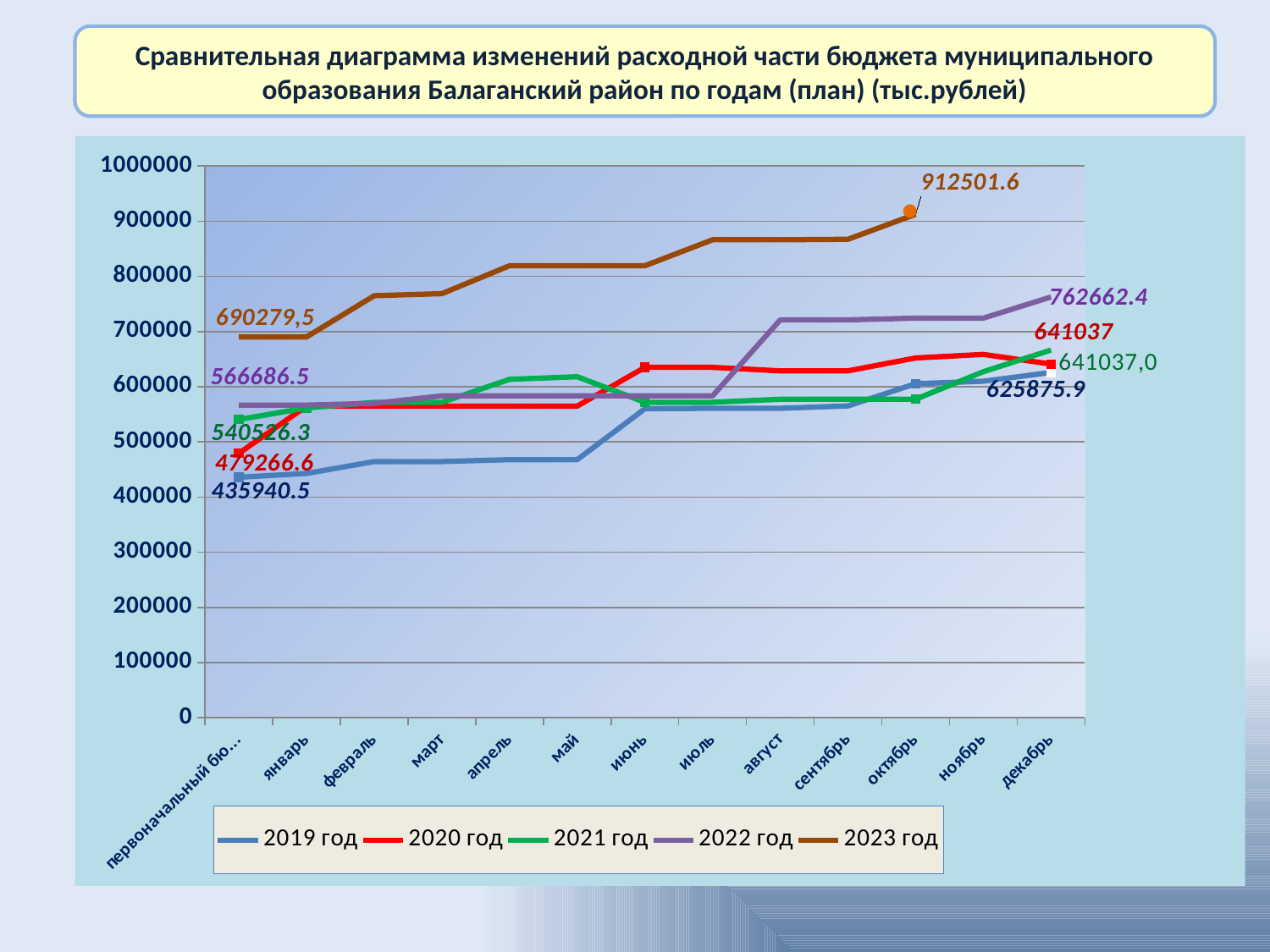
What is the first labelled value of the 2023 год series? 690279,5 What is the value of the 2019 год series in декабрь? 625875.9 How many series does the legend list? 5 By how much does the 2023 год series increase from its first labelled value (690279,5) to its last labelled value (912501.6)? 222222.1 What kind of chart is shown on the slide? line chart Which series has the highest value at the first point (первоначальный бюджет)? 2023 год How many categories are on the x axis? 13 Is the value of the 2022 год series in август greater or less than 700000? greater What is the value labelled at the end of the 2023 год line (октябрь)? 912501.6 What is the first labelled value of the 2019 год series? 435940.5 What is the value of the 2022 год series in декабрь? 762662.4 At the first point, which is larger: the 2022 год value or the 2021 год value? 2022 год